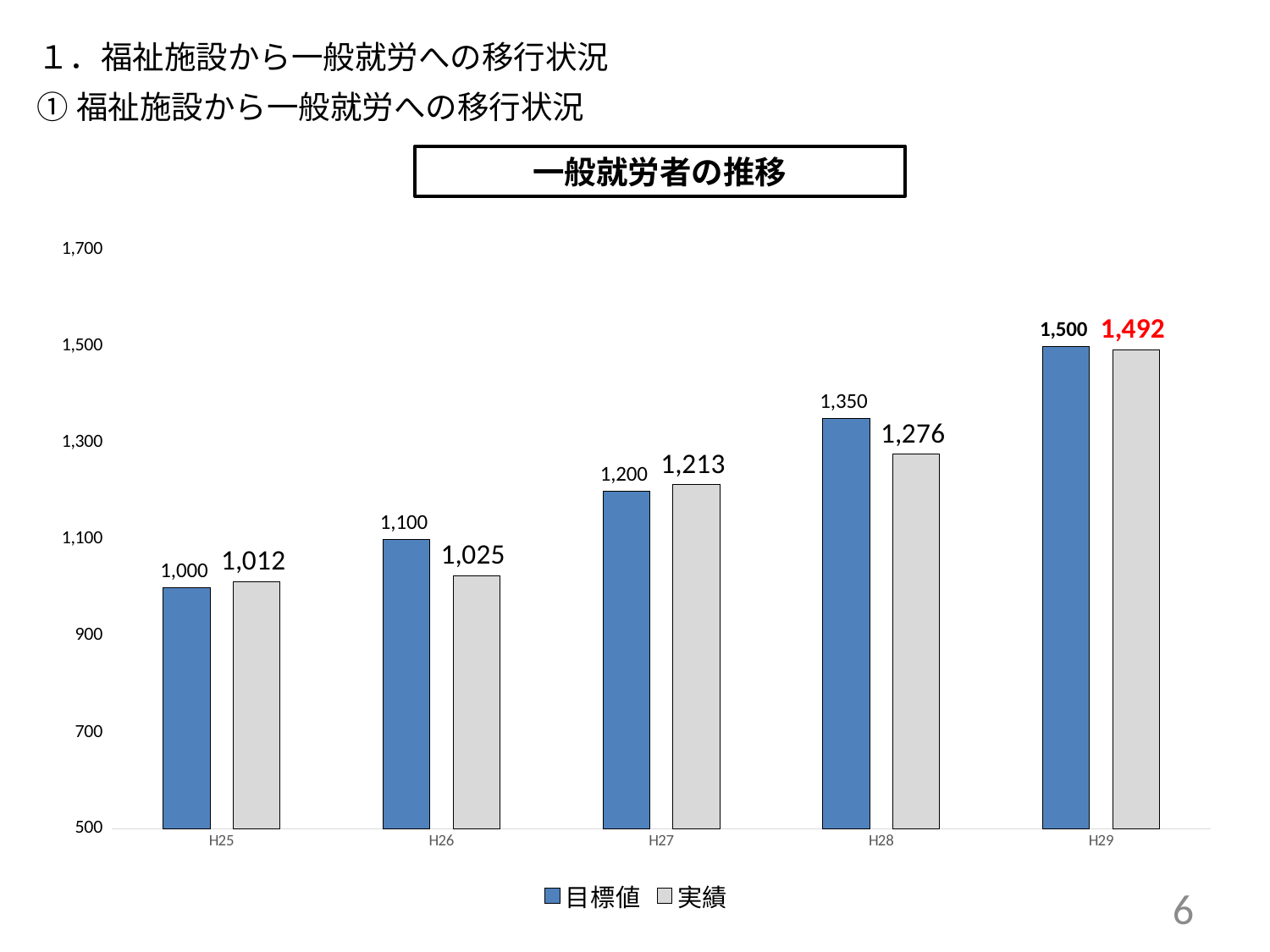
Which year has the highest 実績 value? H29 For H26, which is larger: the 目標値 or the 実績? 目標値 What is the 目標値 (target) value for H27? 1,200 For H25, which is larger: the 目標値 or the 実績? 実績 What kind of chart is shown? Bar chart What is the difference between the 目標値 and 実績 values for H28? 74 What is the 実績 value for H29? 1,492 How many series does the legend list? 2 What is the 実績 (actual) value for H28? 1,276 Do the 実績 values rise or fall from H25 to H29? Rise How many years are shown on the x axis? 5 Which year has the lowest 目標値 value? H25